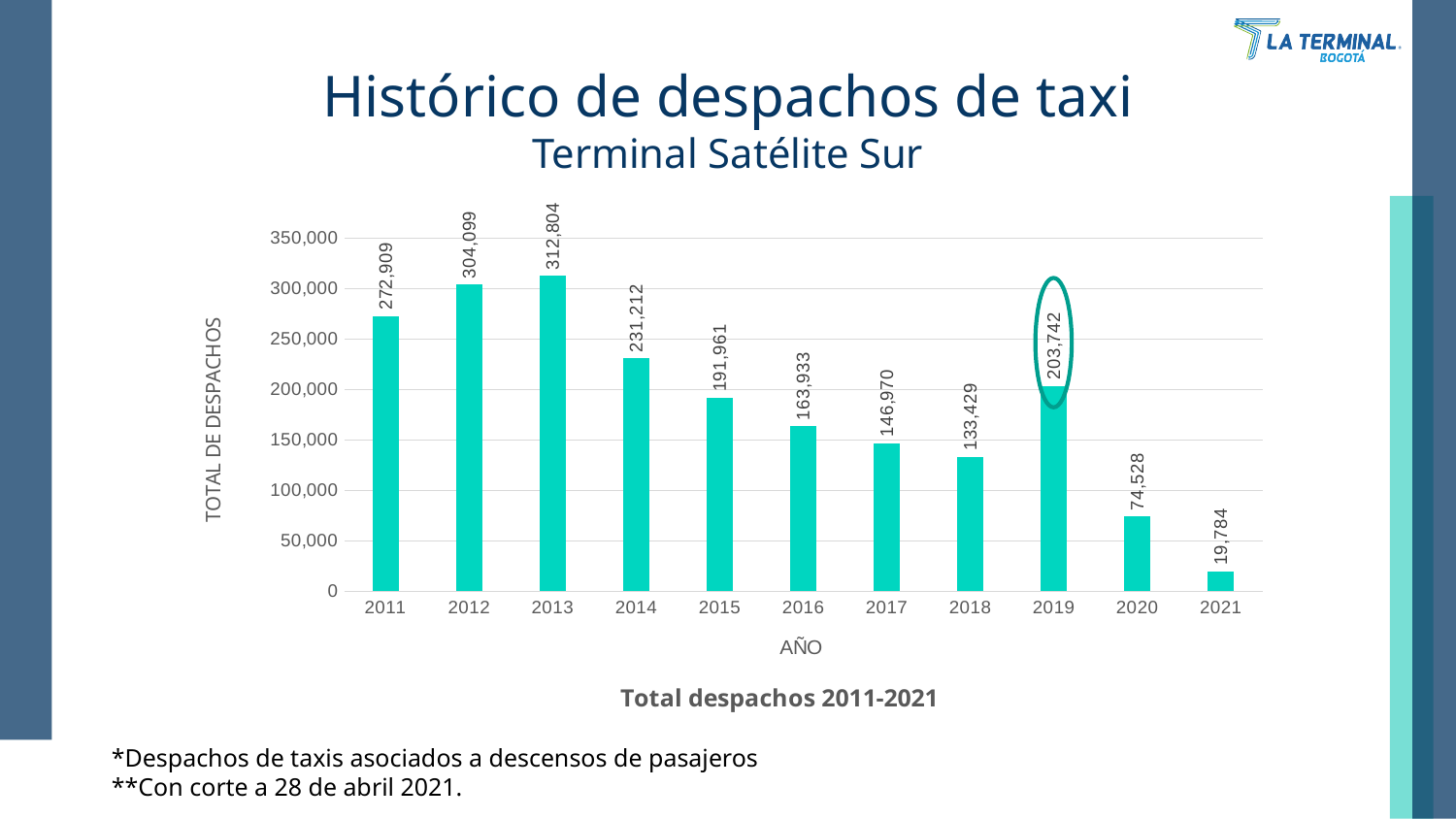
What kind of chart is shown on the slide? bar chart Which year has the lowest value? 2021 Is the value for 2017 greater or less than 150,000? less What is the value for 2013? 312,804 What is the difference between the values for 2019 and 2018? 70,313 What is the difference between the values for 2013 and 2012? 8,705 What is the value for 2019, the bar circled on the chart? 203,742 What is the value for 2021? 19,784 How many years are shown on the x axis? 11 Which is larger, the value for 2014 or the value for 2019? 2014 What is the label of the y axis? TOTAL DE DESPACHOS Which year has the highest value? 2013